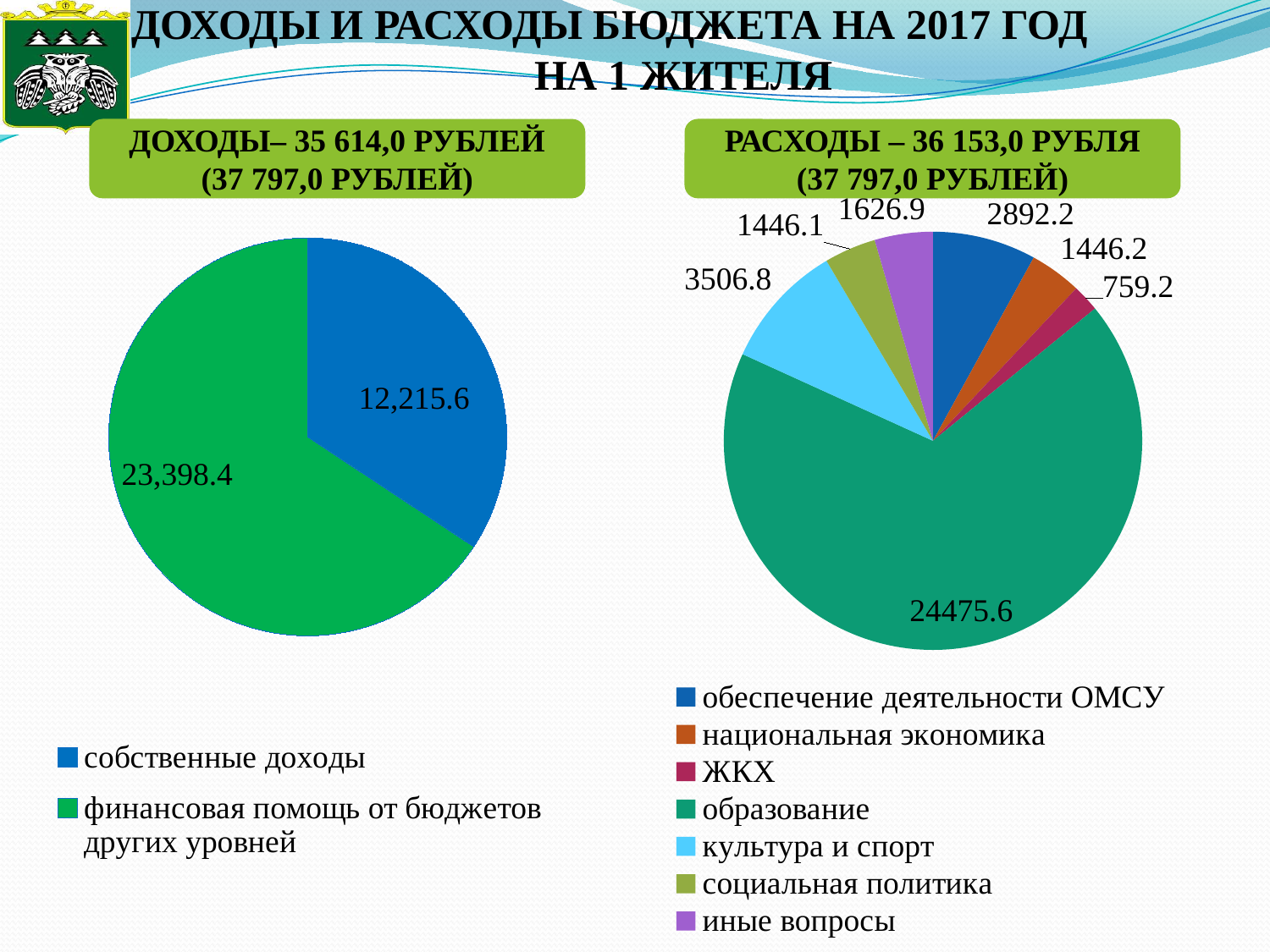
In the right pie chart (РАСХОДЫ), which category has the largest value? образование In the right pie chart (РАСХОДЫ), what is the value for образование? 24475.6 In the left pie chart (ДОХОДЫ), what is the difference between финансовая помощь от бюджетов других уровней and собственные доходы? 11,182.8 In the left pie chart (ДОХОДЫ), what is the value for собственные доходы? 12,215.6 In the right pie chart (РАСХОДЫ), which category has the smallest value? ЖКХ In the left pie chart (ДОХОДЫ), what is the value for финансовая помощь от бюджетов других уровней? 23,398.4 In the right pie chart (РАСХОДЫ), what is the difference between образование and культура и спорт? 20968.8 How many categories does the legend of the right pie chart (РАСХОДЫ) list? 7 In the left pie chart (ДОХОДЫ), what share of the total does собственные доходы represent? 34.3% In the right pie chart (РАСХОДЫ), what is the value for культура и спорт? 3506.8 What type of chart is used on the left side of the slide (ДОХОДЫ)? pie chart In the right pie chart (РАСХОДЫ), which is larger: культура и спорт or обеспечение деятельности ОМСУ? культура и спорт